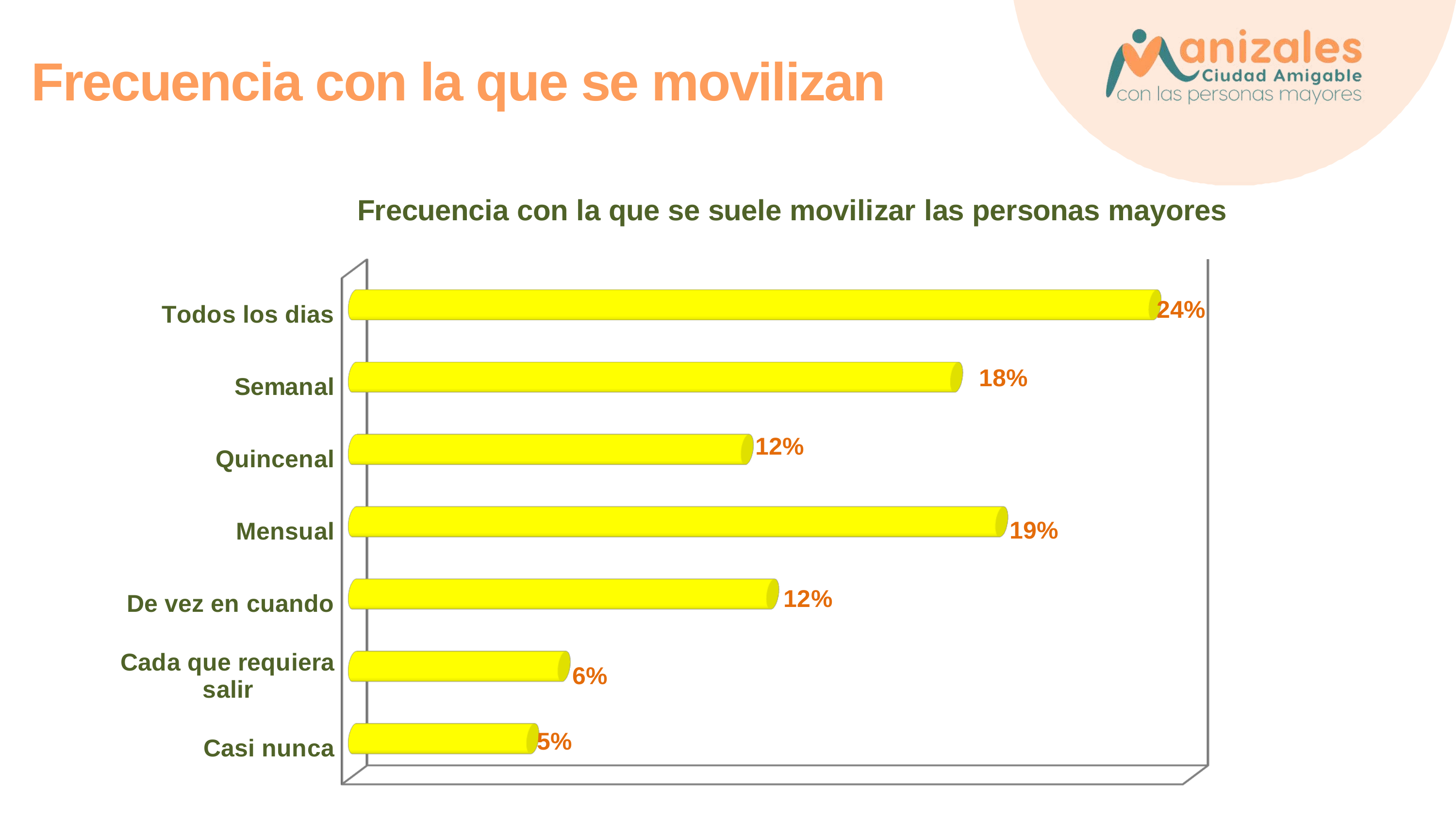
Which category has the lowest value? Casi nunca How many categories are shown in the chart? 7 What is the value for Mensual? 19% What colour are the bars in the chart? Yellow What is the difference between the values for Todos los dias and Semanal? 6% What is the value for Cada que requiera salir? 6% What is the value for Semanal? 18% Which is larger, the value for Mensual or the value for Quincenal? Mensual What kind of chart is shown on the slide? Bar chart What is the title of the chart? Frecuencia con la que se suele movilizar las personas mayores Which category has the highest value? Todos los dias What is the value for Todos los dias? 24%